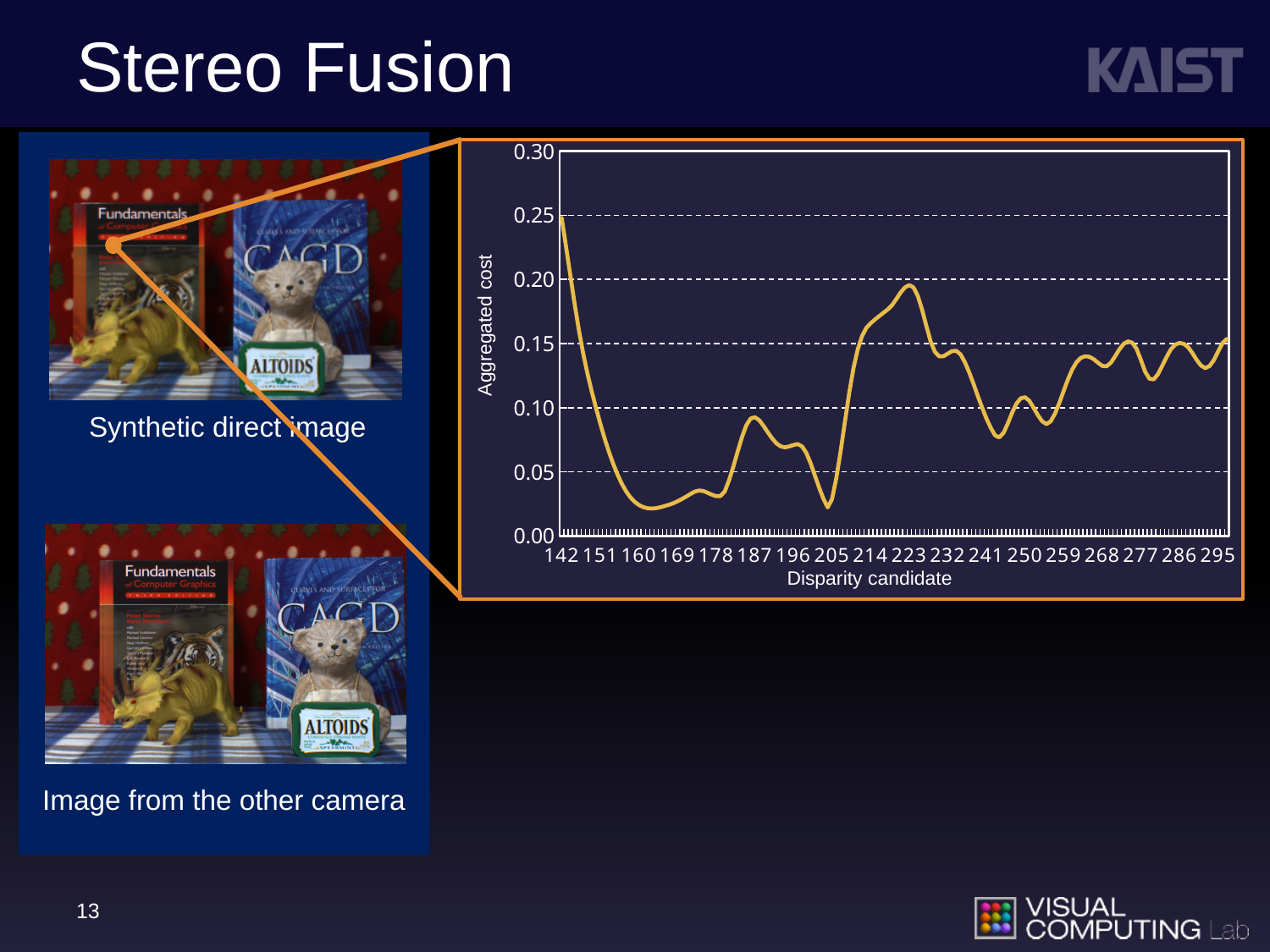
What is the label of the y axis of the chart? Aggregated cost Is the aggregated cost at disparity candidate 223 greater or less than 0.15? greater Which has the larger aggregated cost, disparity candidate 142 or disparity candidate 160? 142 Does the aggregated cost rise or fall between disparity candidates 142 and 160? fall What kind of chart is shown on the slide? line chart Is the aggregated cost at disparity candidate 142 greater or less than 0.20? greater Is the aggregated cost at disparity candidate 160 greater or less than 0.05? less At which labelled disparity candidate is the aggregated cost highest? 142 What is the label of the x axis of the chart? Disparity candidate